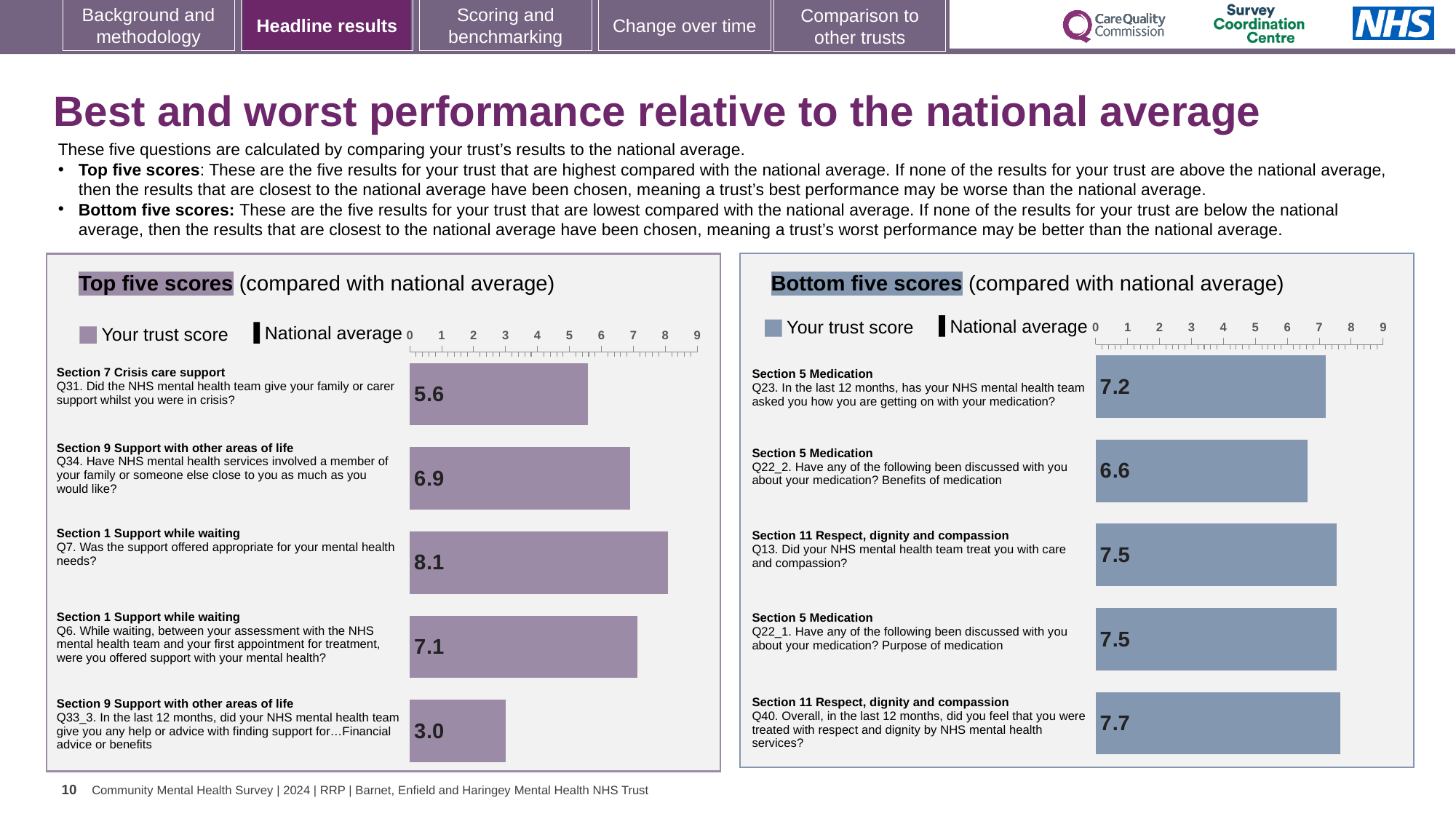
In the Top five scores chart, what is the difference between the trust scores for Q7 and Q33_3? 5.1 In the Bottom five scores chart, what is the difference between the trust scores for Q40 and Q22_2? 1.1 In the Bottom five scores chart, which question has the lowest trust score? Q22_2 (Section 5 Medication) In the Top five scores chart, which question has the lowest trust score? Q33_3 (Section 9 Support with other areas of life) What type of chart is used in the Bottom five scores panel? Bar chart In the Bottom five scores chart, which question has the highest trust score? Q40 (Section 11 Respect, dignity and compassion) In the Bottom five scores chart, what is the trust score for Q40 (treated with respect and dignity by NHS mental health services)? 7.7 In the Bottom five scores chart, which has the larger trust score: Q23 or Q22_2? Q23 In the Top five scores chart, which question has the highest trust score? Q7 (Section 1 Support while waiting) In the Top five scores chart, what is the trust score for Q7 (Was the support offered appropriate for your mental health needs?)? 8.1 What two entries does the legend of the Top five scores chart list? Your trust score and National average How many questions are shown in the Top five scores chart? 5